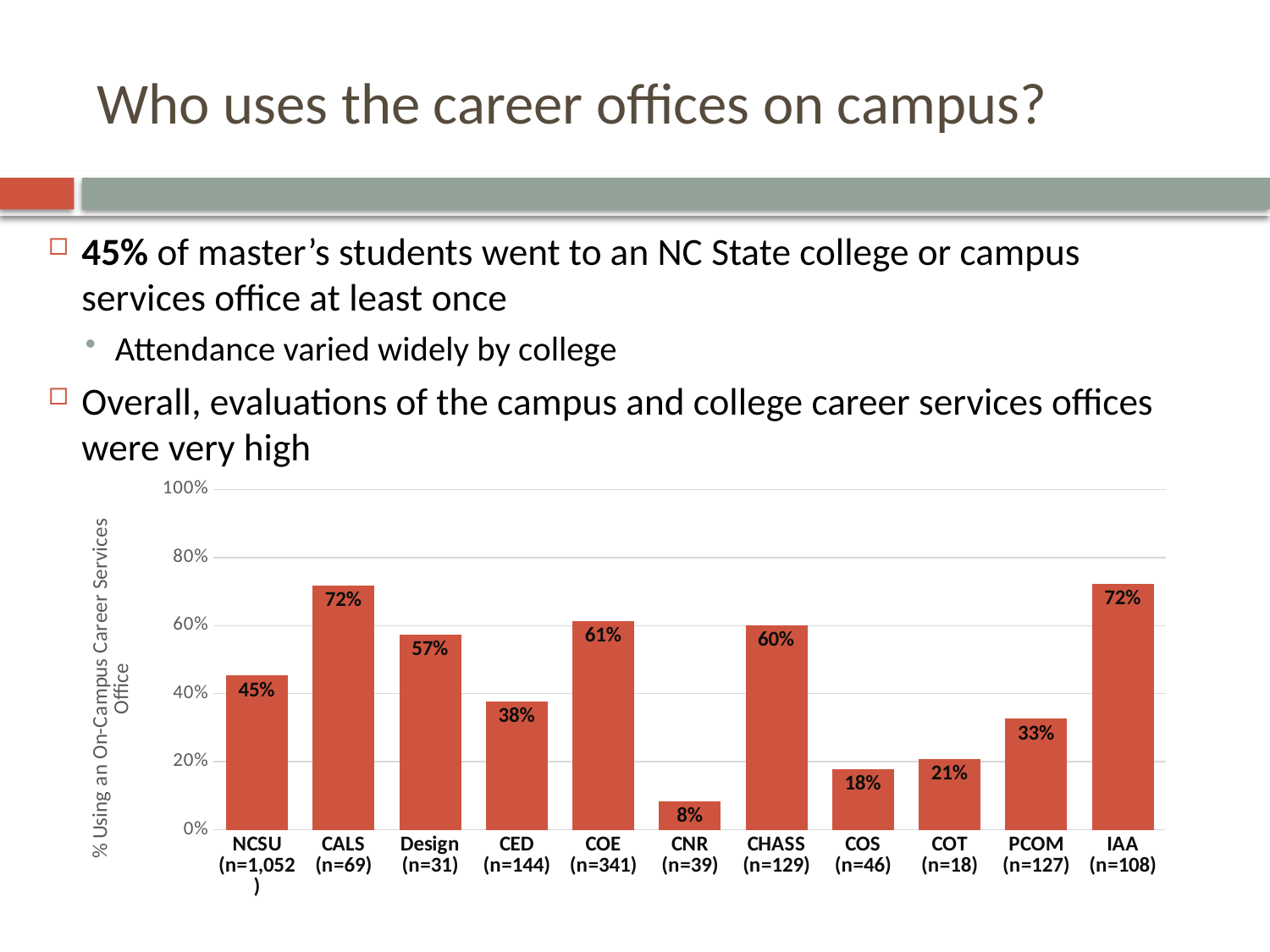
What is the label of the chart's y axis? % Using an On-Campus Career Services Office What is the value shown for CNR (n=39)? 8% What type of chart is shown on the slide? Bar chart What is the difference between the percentages for COE and CED? 23% What is the difference between the values for IAA and COS? 54% Which is larger, the value for CHASS or the value for PCOM? CHASS What percentage is shown for PCOM (n=127)? 33% What percentage of CALS students used an on-campus career services office? 72% Which college has the lowest percentage using an on-campus career services office? CNR What is the sample size (n) shown for COE? 341 Which has a higher percentage, Design or COT? Design How many colleges or groups are shown on the x axis of the chart? 11